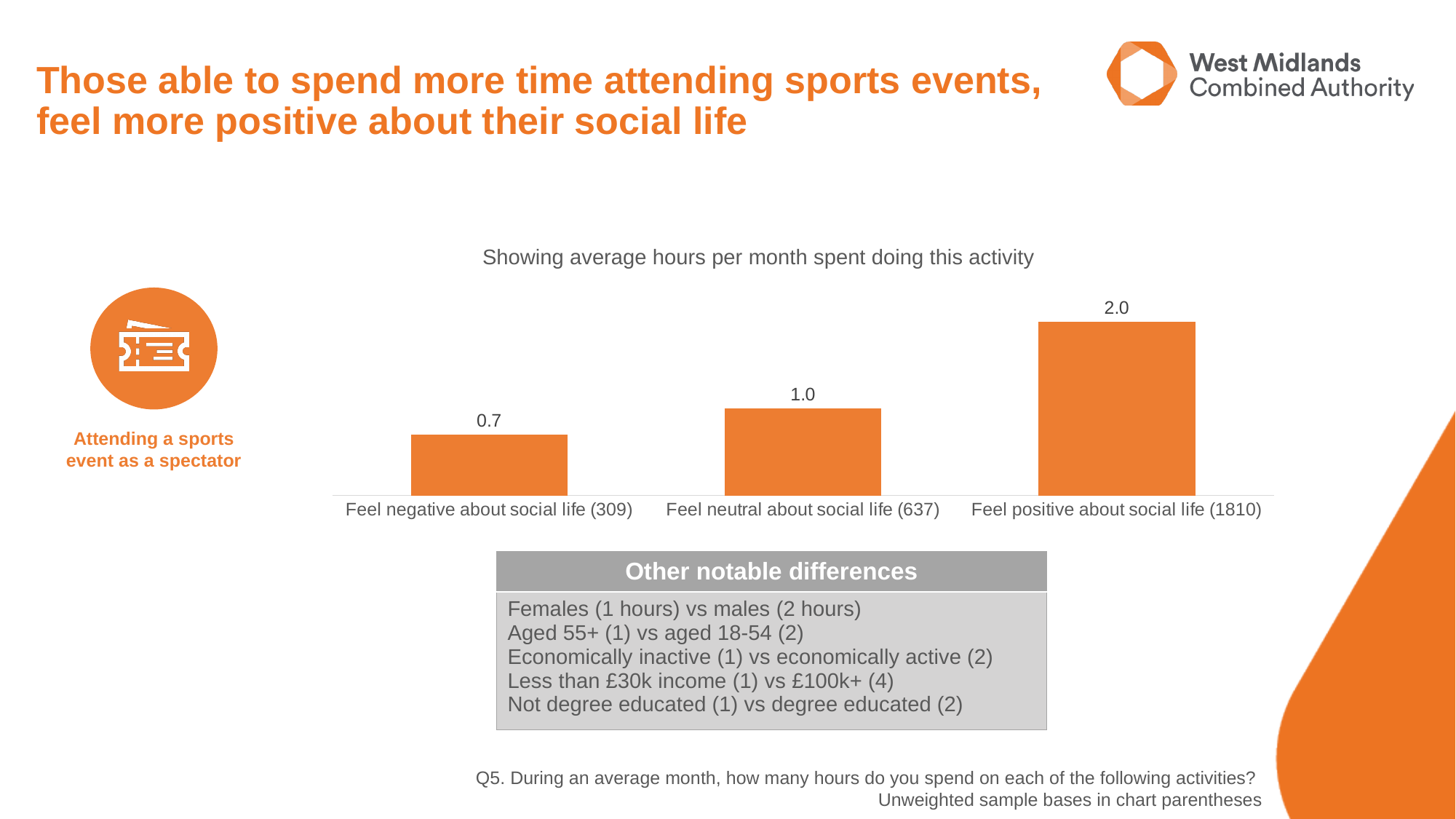
What is the average hours per month for 'Feel positive about social life (1810)'? 2.0 Which category has the highest average hours per month? Feel positive about social life (1810) What is the difference in average hours per month between 'Feel positive about social life (1810)' and 'Feel negative about social life (309)'? 1.3 Which category has the lowest average hours per month? Feel negative about social life (309) What is the average hours per month for 'Feel neutral about social life (637)'? 1.0 What is the subtitle shown above the chart? Showing average hours per month spent doing this activity How many categories are shown in the chart? 3 Which is larger: the value for 'Feel neutral about social life (637)' or 'Feel negative about social life (309)'? Feel neutral about social life (637) What is the average hours per month for 'Feel negative about social life (309)'? 0.7 What kind of chart is shown on the slide? Bar chart What is the difference in average hours per month between 'Feel positive about social life (1810)' and 'Feel neutral about social life (637)'? 1.0 Do the values rise or fall moving from left to right across the categories? Rise